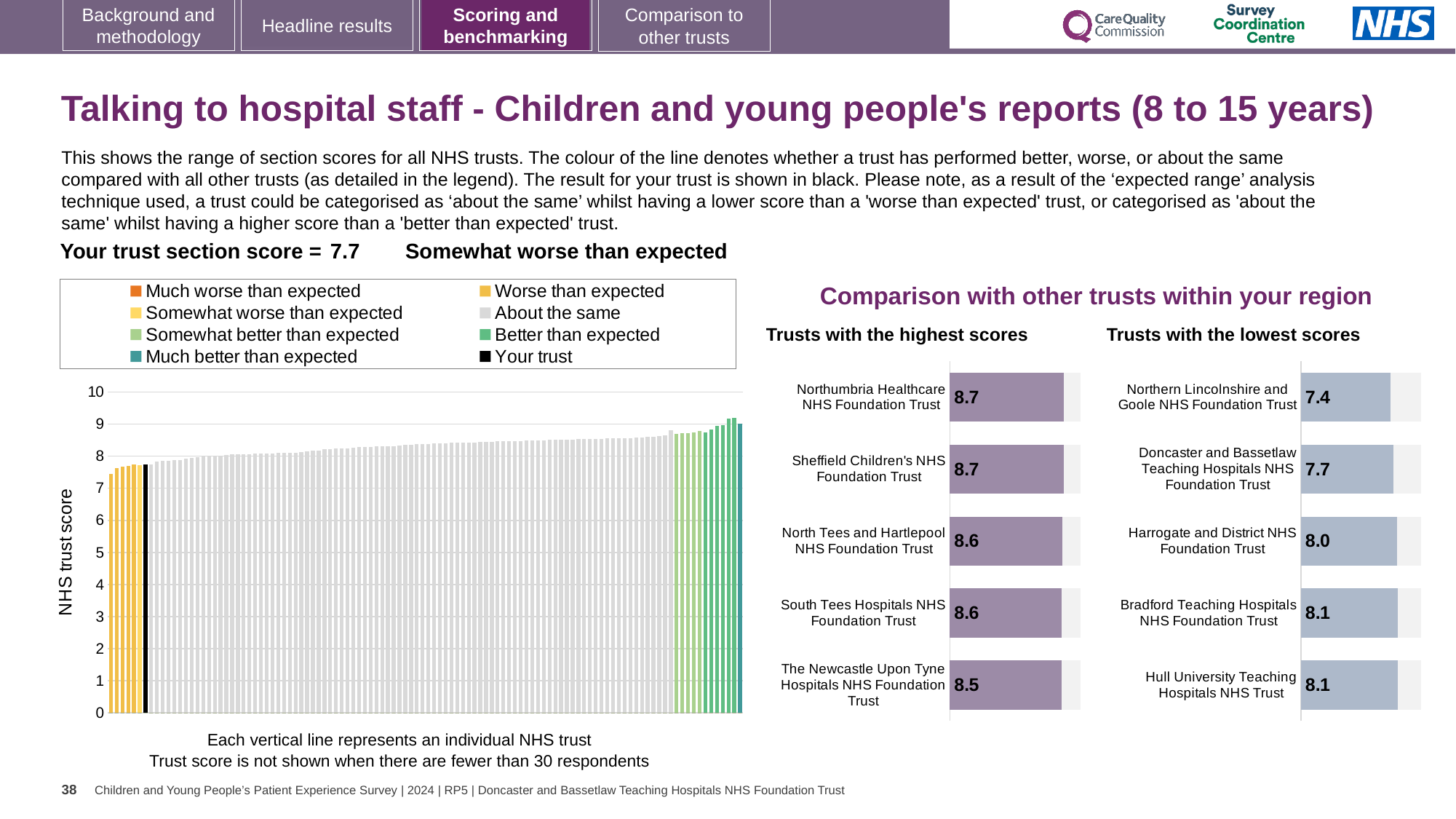
In the 'Trusts with the highest scores' chart, what is the score for Northumbria Healthcare NHS Foundation Trust? 8.7 How many entries does the legend of the large chart on the left list? 8 In the large chart on the left showing all NHS trusts, is the value for the lowest-scoring trust greater or less than 8? less In the 'Trusts with the lowest scores' chart, what is the score for Harrogate and District NHS Foundation Trust? 8.0 In the 'Trusts with the highest scores' chart, what is the score for The Newcastle Upon Tyne Hospitals NHS Foundation Trust? 8.5 In the 'Trusts with the highest scores' chart, what is the difference between the scores of Northumbria Healthcare NHS Foundation Trust and The Newcastle Upon Tyne Hospitals NHS Foundation Trust? 0.2 How many trusts are shown in the 'Trusts with the highest scores' chart? 5 What kind of chart is the large chart on the left showing all NHS trusts? bar chart In the 'Trusts with the lowest scores' chart, what is the difference between the scores of Hull University Teaching Hospitals NHS Trust and Northern Lincolnshire and Goole NHS Foundation Trust? 0.7 In the 'Trusts with the lowest scores' chart, which has the higher score: Harrogate and District NHS Foundation Trust or Doncaster and Bassetlaw Teaching Hospitals NHS Foundation Trust? Harrogate and District NHS Foundation Trust In the 'Trusts with the lowest scores' chart, which trust has the lowest score? Northern Lincolnshire and Goole NHS Foundation Trust In the large chart on the left showing all NHS trusts, do the values rise or fall from left to right? rise